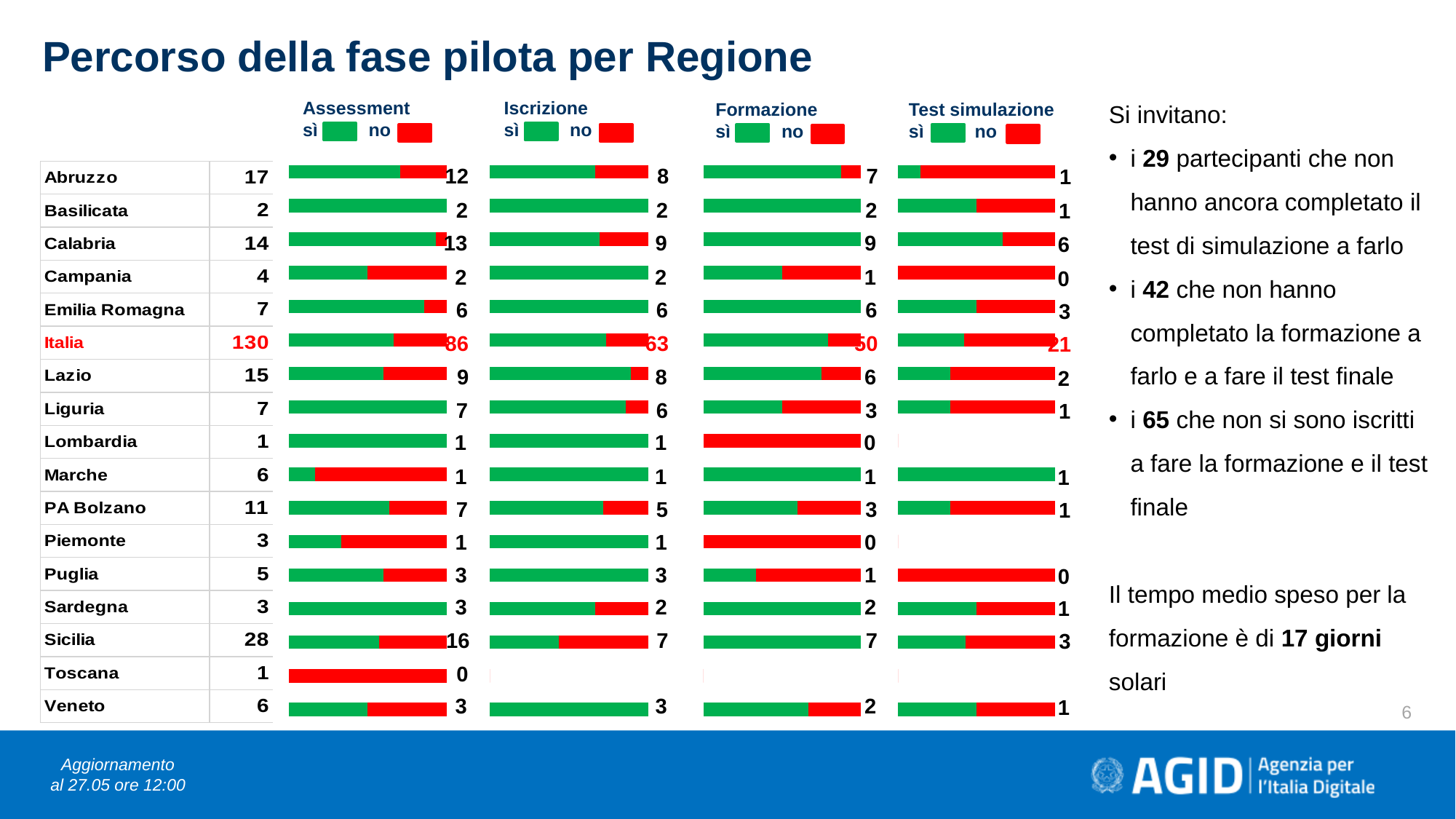
In the Assessment chart, what is the 'sì' value for Abruzzo? 12 In the Assessment chart, which region (excluding the Italia total row) has the highest 'sì' value? Sicilia In the legends of the charts, which colour represents 'sì'? Green In the Assessment chart, which region has the lowest 'sì' value? Toscana In the Formazione chart, what is the 'sì' value for Italia? 50 In the Iscrizione chart, what is the 'sì' value for Calabria? 9 What is the difference between Abruzzo's 'sì' value in the Assessment chart (12) and in the Iscrizione chart (8)? 4 What kind of chart is used for the Formazione data? Bar chart How many series does the legend of the Assessment chart list? 2 In the Assessment chart, which has the larger 'sì' value, Calabria or Sicilia? Sicilia In the Test simulazione chart, what is the 'sì' value for Calabria? 6 How many rows (regions including Italia) are plotted in the Assessment chart? 17